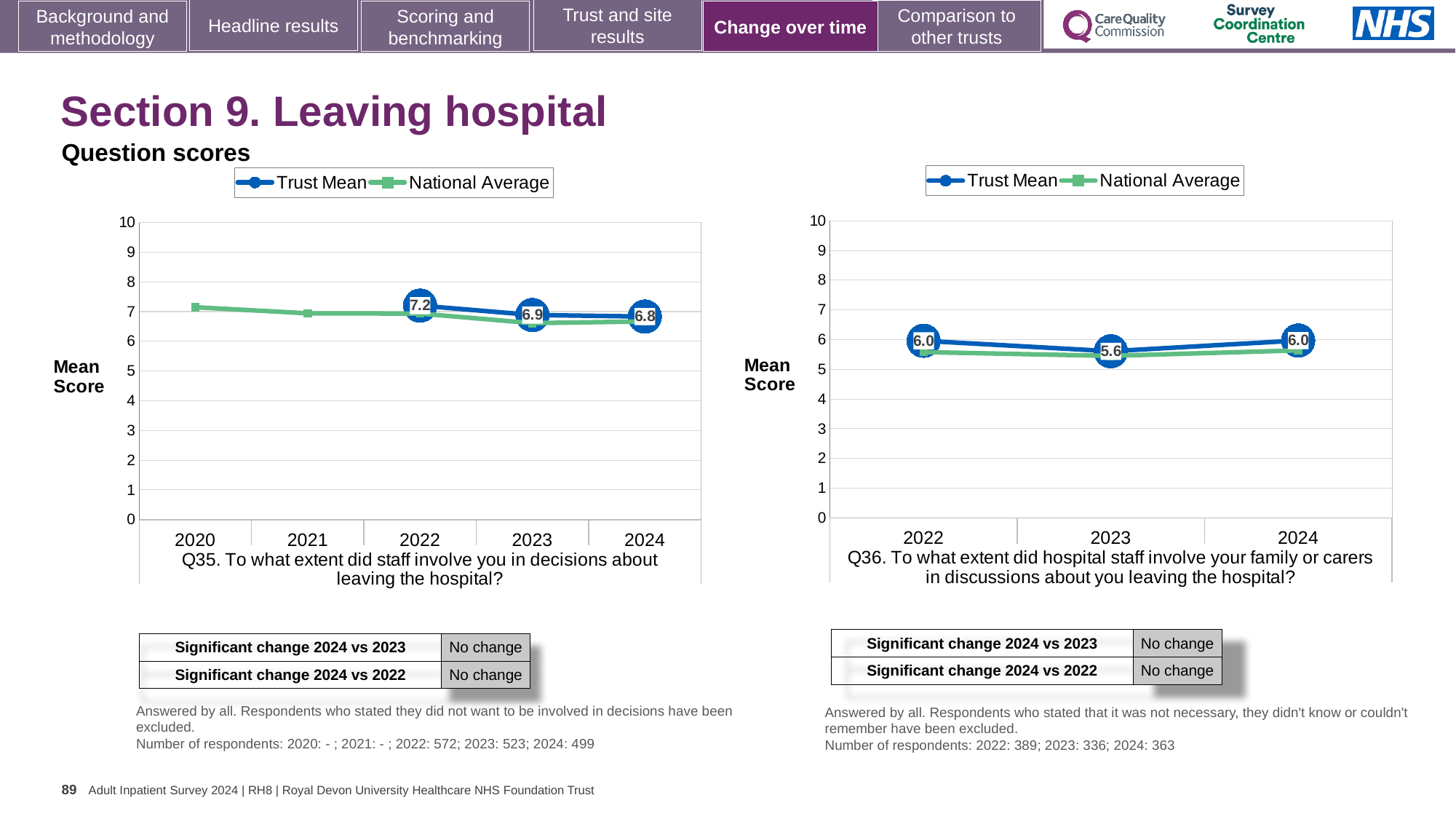
In the Q35 chart (left), how many series does the legend list? 2 In the Q35 chart (left), what is the Trust Mean score for 2024? 6.8 In the Q35 chart (left), what is the difference between the Trust Mean scores for 2022 and 2024? 0.4 In the Q36 chart (right), how many years are shown on the x axis? 3 In the Q35 chart (left), what is the Trust Mean score for 2022? 7.2 In the Q35 chart (left), does the Trust Mean score rise or fall from 2022 to 2024? fall In the Q35 chart (left), which year has the highest labelled Trust Mean score? 2022 In the Q36 chart (right), which year has the lowest Trust Mean score? 2023 In the Q36 chart (right), what is the Trust Mean score for 2024? 6.0 In the Q36 chart (right), what is the Trust Mean score for 2023? 5.6 In the Q35 chart (left), is the Trust Mean score for 2023 greater or less than 6? greater In the Q36 chart (right), what is the difference between the Trust Mean scores for 2022 and 2023? 0.4